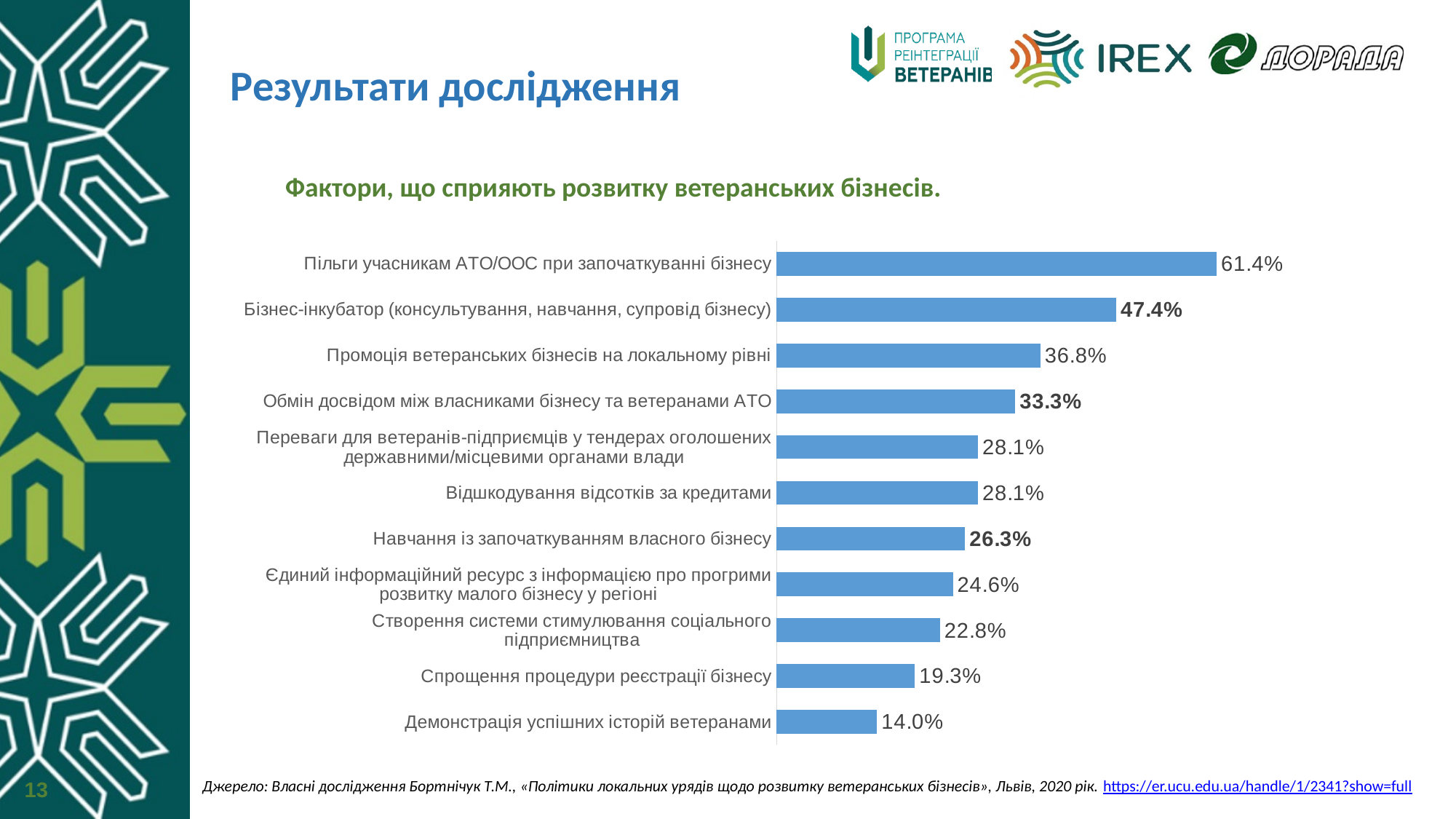
What is the value for "Пільги учасникам АТО/ООС при започаткуванні бізнесу"? 61.4% What is the value for "Спрощення процедури реєстрації бізнесу"? 19.3% What is the value for "Бізнес-інкубатор (консультування, навчання, супровід бізнесу)"? 47.4% What is the value for "Відшкодування відсотків за кредитами"? 28.1% Which category has the highest value? Пільги учасникам АТО/ООС при започаткуванні бізнесу What is the title of the chart? Фактори, що сприяють розвитку ветеранських бізнесів. What kind of chart is shown on the slide? Bar chart What is the difference between the values for "Пільги учасникам АТО/ООС при започаткуванні бізнесу" and "Бізнес-інкубатор (консультування, навчання, супровід бізнесу)"? 14.0 percentage points How many categories are shown in the chart? 11 What is the difference between the values for "Промоція ветеранських бізнесів на локальному рівні" and "Обмін досвідом між власниками бізнесу та ветеранами АТО"? 3.5 percentage points Which is larger: the value for "Навчання із започаткуванням власного бізнесу" or for "Створення системи стимулювання соціального підприємництва"? Навчання із започаткуванням власного бізнесу Which category has the lowest value? Демонстрація успішних історій ветеранами